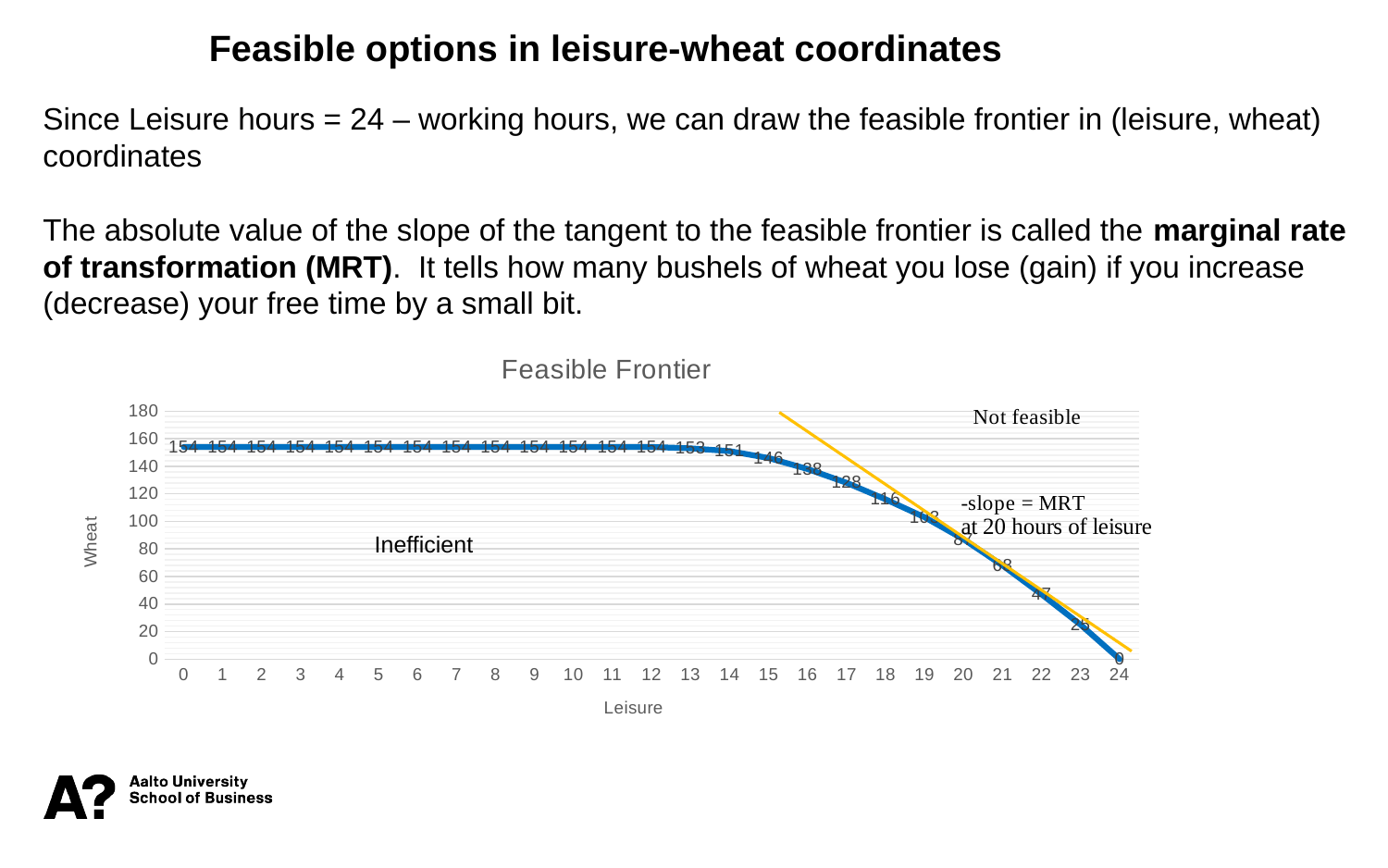
Which has more wheat: 19 hours of leisure or 21 hours of leisure? 19 hours of leisure What is the wheat value at 17 hours of leisure? 128 What is the wheat value at 24 hours of leisure? 0 Does wheat rise or fall as leisure increases along the x axis? fall What are the titles of the x axis and y axis? Leisure and Wheat What kind of chart is shown on the slide? line chart What is the wheat value at 22 hours of leisure? 47 What is the wheat value at 0 hours of leisure? 154 Is the wheat value at 20 hours of leisure greater or less than 100? less What is the difference in wheat between 16 and 17 hours of leisure? 10 At which leisure value is wheat lowest? 24 What is the title of the chart? Feasible Frontier